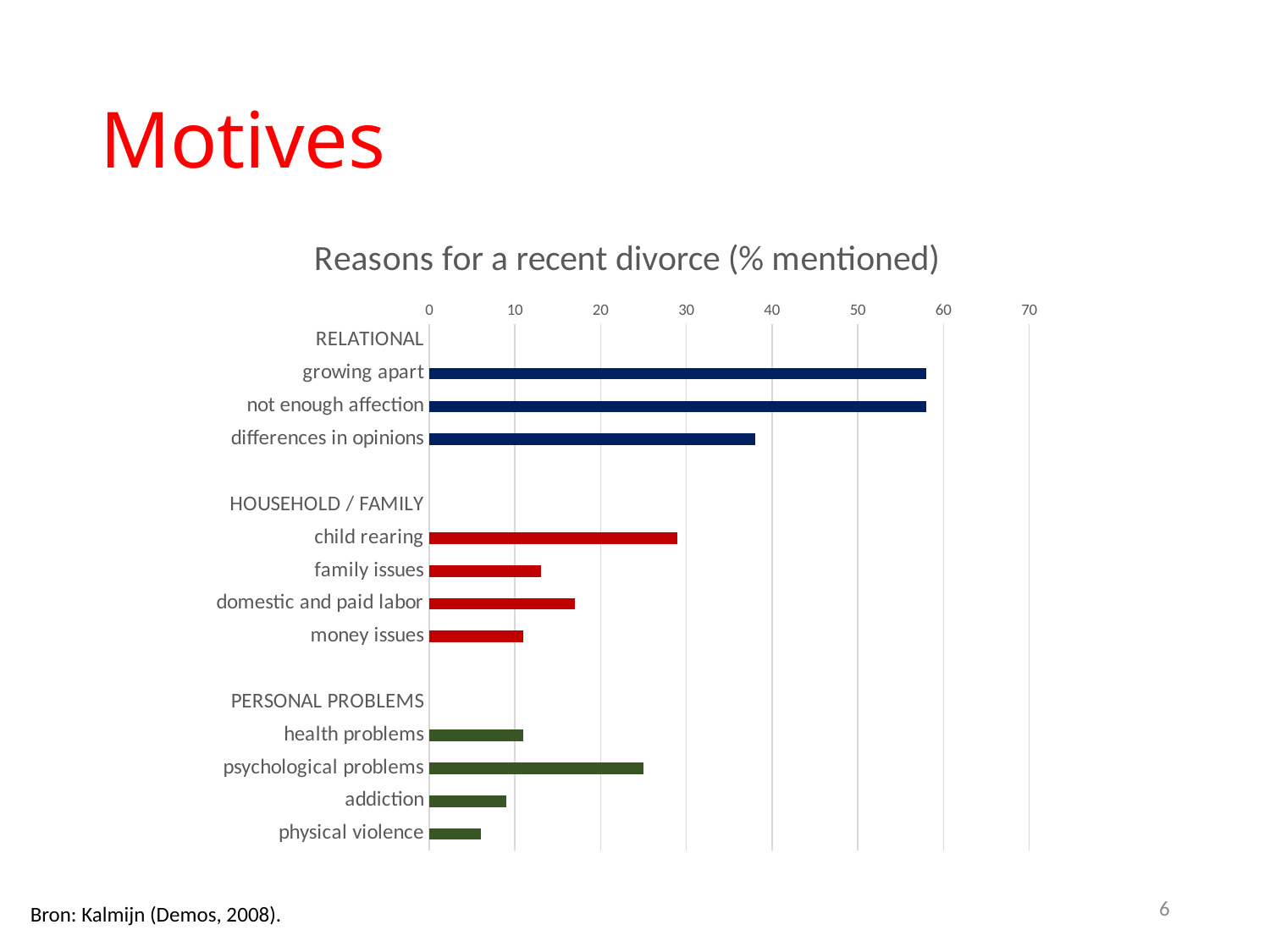
Is the value for differences in opinions greater or less than 30? greater Is the value for psychological problems greater or less than 20? greater What is the title of the chart? Reasons for a recent divorce (% mentioned) Which has a larger value, domestic and paid labor or family issues? domestic and paid labor Which reason has the lowest value in the chart? physical violence Is the value for growing apart greater or less than 50? greater What type of chart is shown on the slide? bar chart How many bars are plotted in the chart? 11 Which has a larger value, child rearing or psychological problems? child rearing